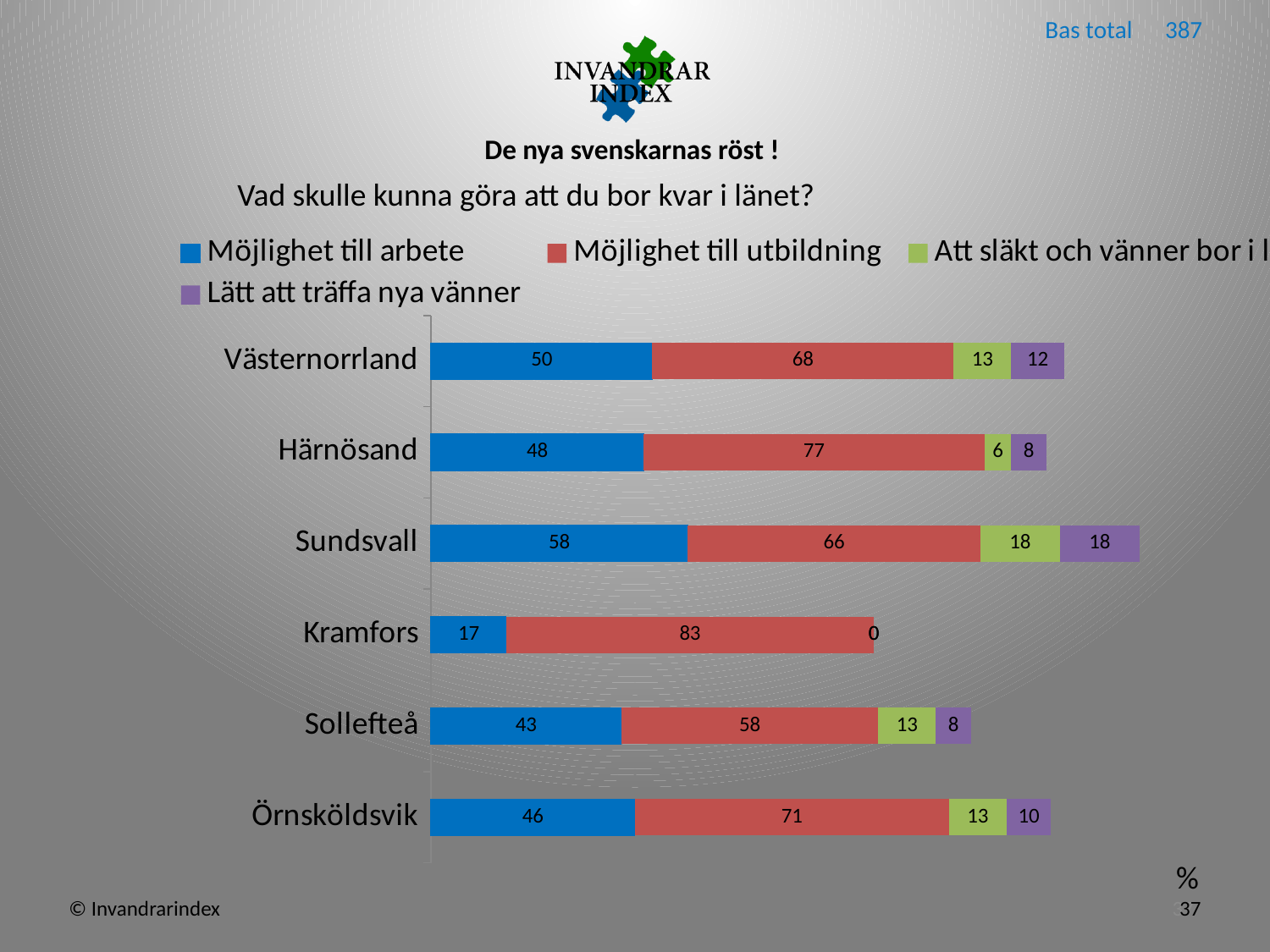
What is the total of the stacked bar for Sundsvall? 160 What is the value of Möjlighet till arbete for Sundsvall? 58 Which category has the lowest value for Möjlighet till arbete? Kramfors What is the difference between Möjlighet till utbildning and Möjlighet till arbete for Västernorrland? 18 What question is the chart about, as shown above the legend? Vad skulle kunna göra att du bor kvar i länet? What is the value of Möjlighet till utbildning for Härnösand? 77 How many series does the legend list? 4 How many categories are shown on the chart? 6 Which category has the highest value for Möjlighet till utbildning? Kramfors Which is larger for Sollefteå: Möjlighet till arbete or Möjlighet till utbildning? Möjlighet till utbildning What is the value of Lätt att träffa nya vänner for Örnsköldsvik? 10 What kind of chart is shown on the slide? Stacked bar chart